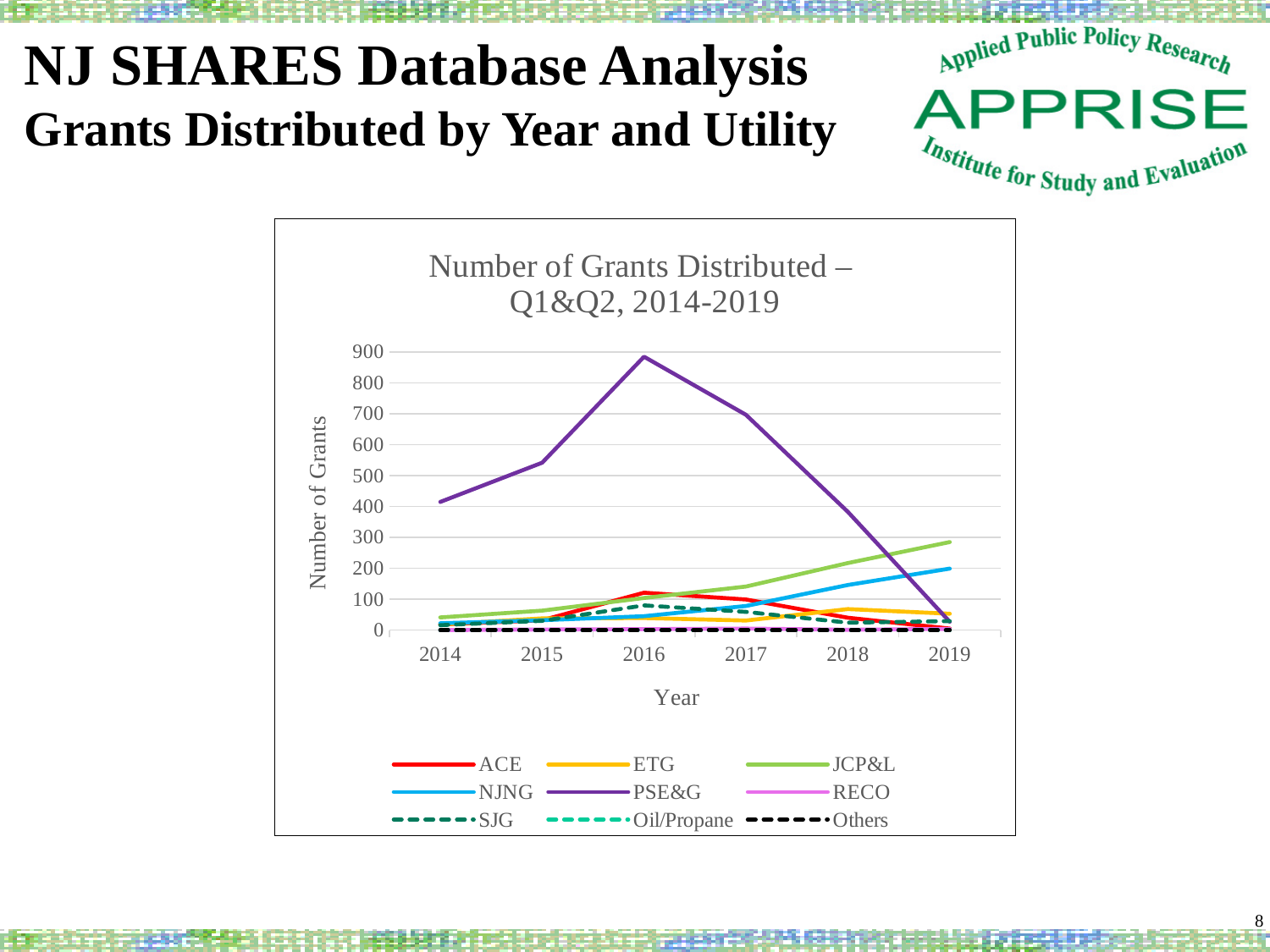
Is the value for PSE&G in 2016 greater or less than 800? greater Which utility had the highest number of grants in 2016? PSE&G Which is larger in 2019, the value for JCP&L or the value for NJNG? JCP&L What kind of chart is shown on the slide? Line chart How many years are shown on the x axis? 6 Is the value for JCP&L in 2019 greater or less than 200? greater Do the values for PSE&G rise or fall from 2016 to 2019? Fall What is the label on the y axis? Number of Grants In which year did PSE&G reach its highest number of grants? 2016 How many series does the legend list? 9 Is the value for PSE&G in 2019 greater or less than 100? less Which utility had the highest number of grants in 2019? JCP&L